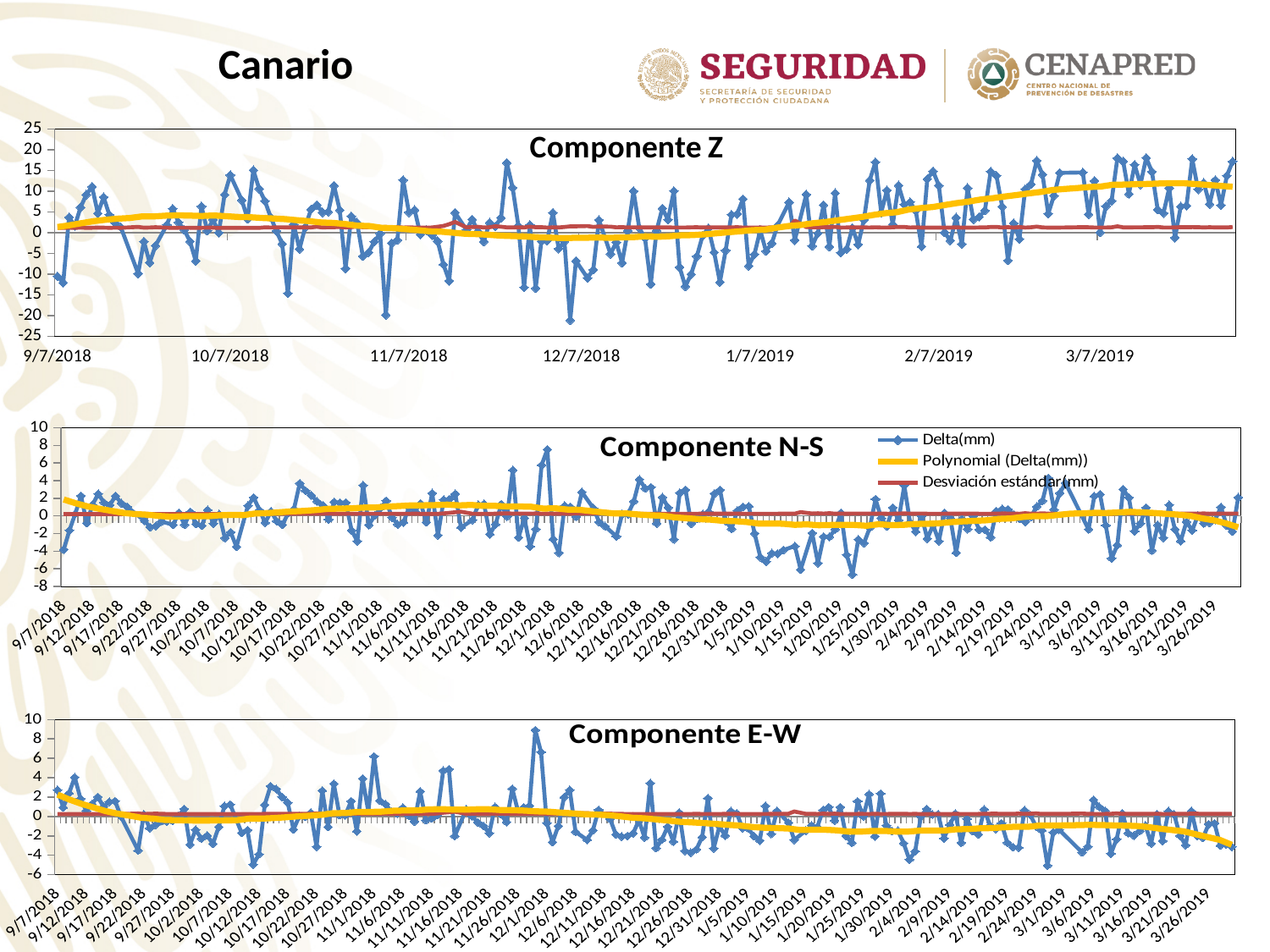
What is the title of the bottom chart on the slide? Componente E-W How many series does the legend on the Componente N-S chart list? 3 What is the maximum value shown on the y axis of the Componente Z chart? 25 In the Componente N-S chart, is the highest plotted Delta value greater or less than 4? greater How many charts are shown on the slide? 3 In the Componente E-W chart, is the highest plotted Delta value greater or less than 6? greater What kind of chart is the Componente Z chart? line chart In the Componente E-W chart, does the yellow polynomial trend line rise or fall overall from left to right? fall In the Componente Z chart, is the lowest plotted Delta value greater or less than -15? less In the Componente N-S chart, which legend entry is drawn in yellow? Polynomial (Delta(mm)) In the Componente Z chart, does the yellow polynomial trend line rise or fall overall from left to right? rise